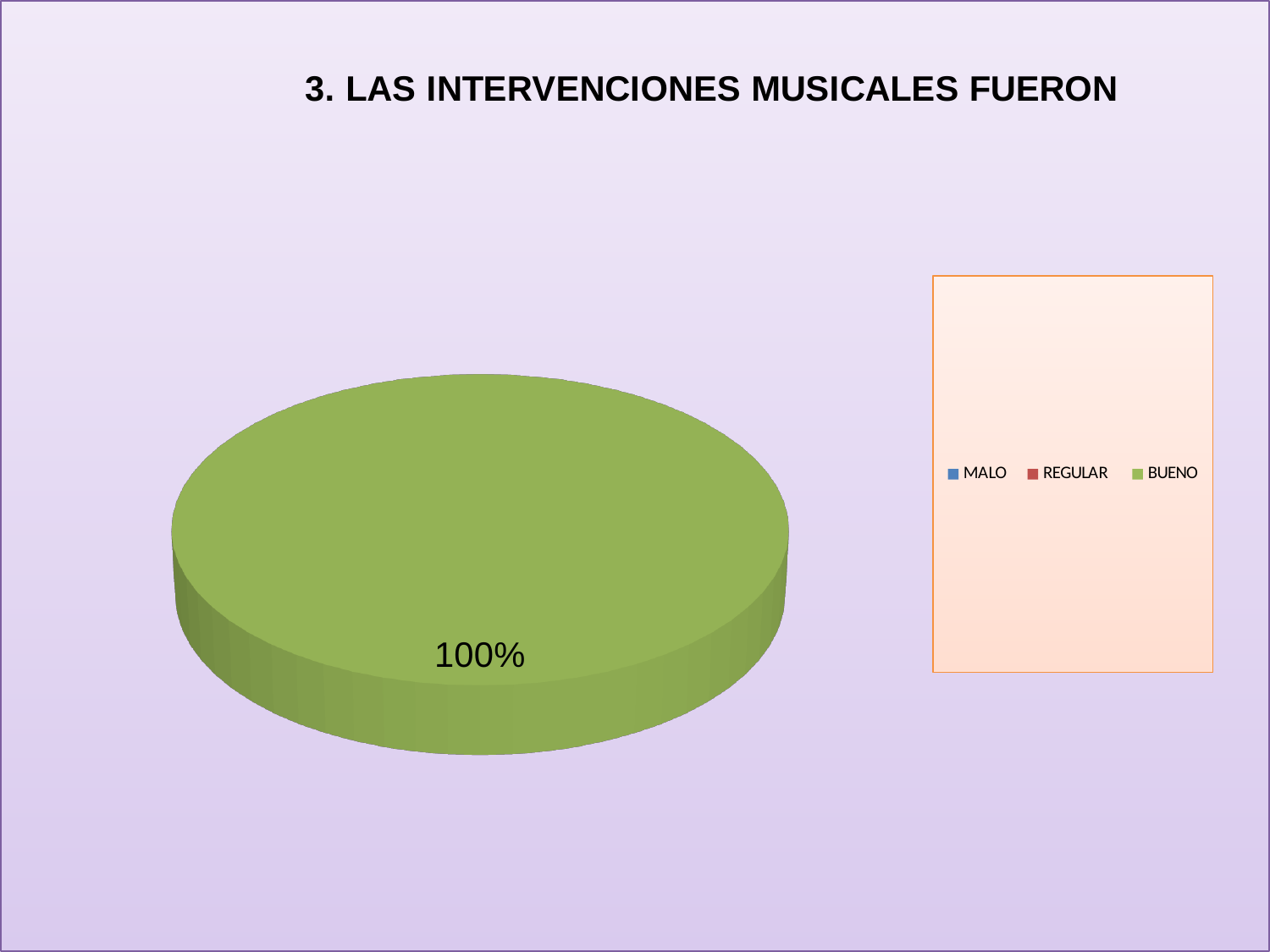
How many categories does the legend list? 3 What kind of chart is shown on the slide? pie chart What share of the pie does BUENO have? 100% Which is larger, the share for BUENO or the share for MALO? BUENO Which category has the largest share of the pie? BUENO How many slices are visible in the pie? 1 What is the title of the chart? 3. LAS INTERVENCIONES MUSICALES FUERON What colour is the BUENO slice? green Which is larger, the share for BUENO or the share for REGULAR? BUENO